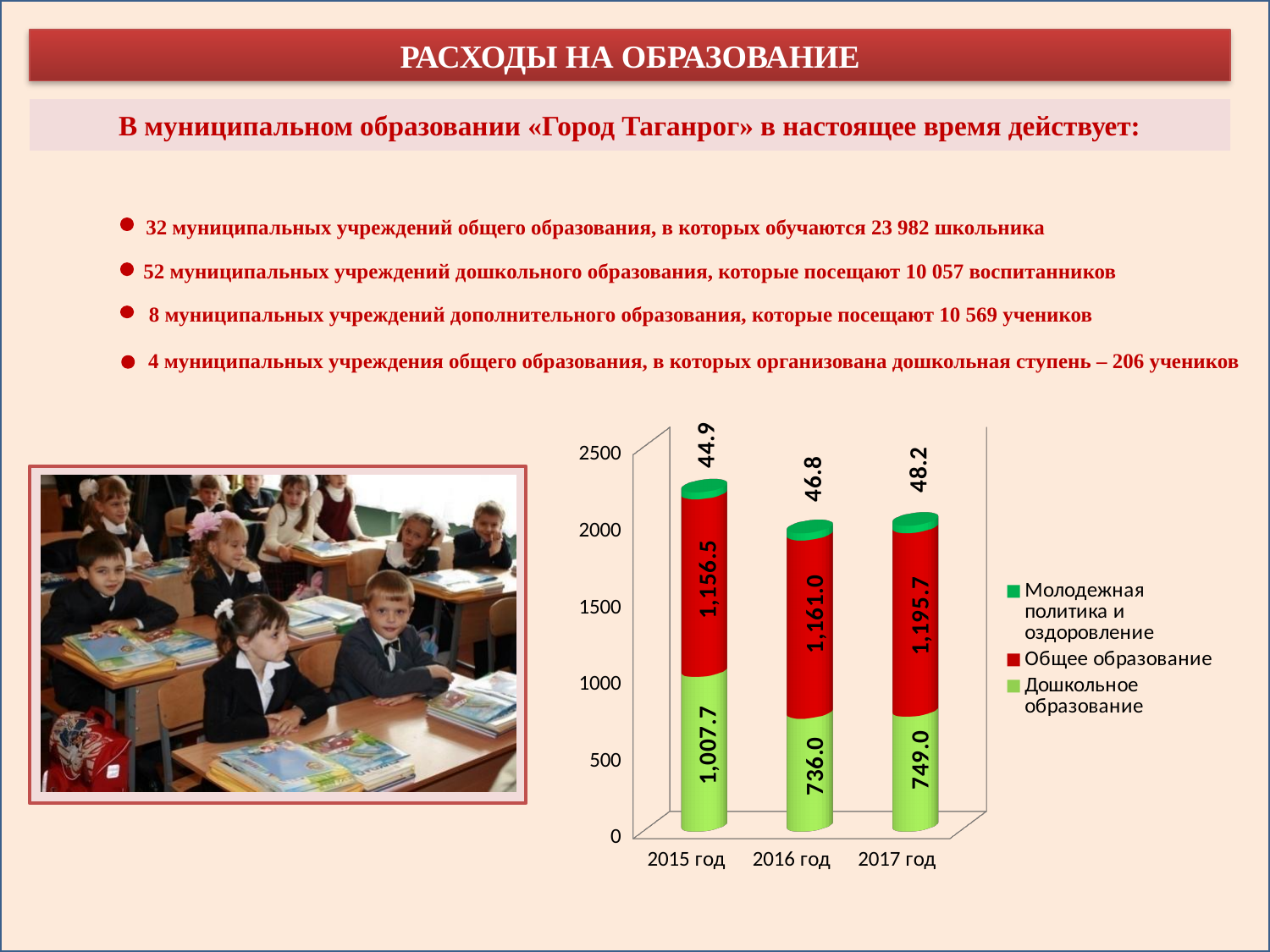
Which is larger: Общее образование in 2016 год or Общее образование in 2015 год? 2016 год Does the value for Молодежная политика и оздоровление rise or fall from 2015 год to 2017 год? rise In which year is the value for Дошкольное образование the lowest? 2016 год What is the value for Молодежная политика и оздоровление in 2016 год? 46.8 How many series does the chart legend list? 3 In which year is the value for Общее образование the highest? 2017 год What is the total of the stacked bar for 2015 год? 2,209.1 What is the difference between the Дошкольное образование values for 2015 год and 2016 год? 271.7 What is the value for Дошкольное образование in 2015 год? 1,007.7 What is the value for Общее образование in 2017 год? 1,195.7 How many years (categories) are shown on the x axis of the chart? 3 What type of chart is shown on the slide? stacked bar chart